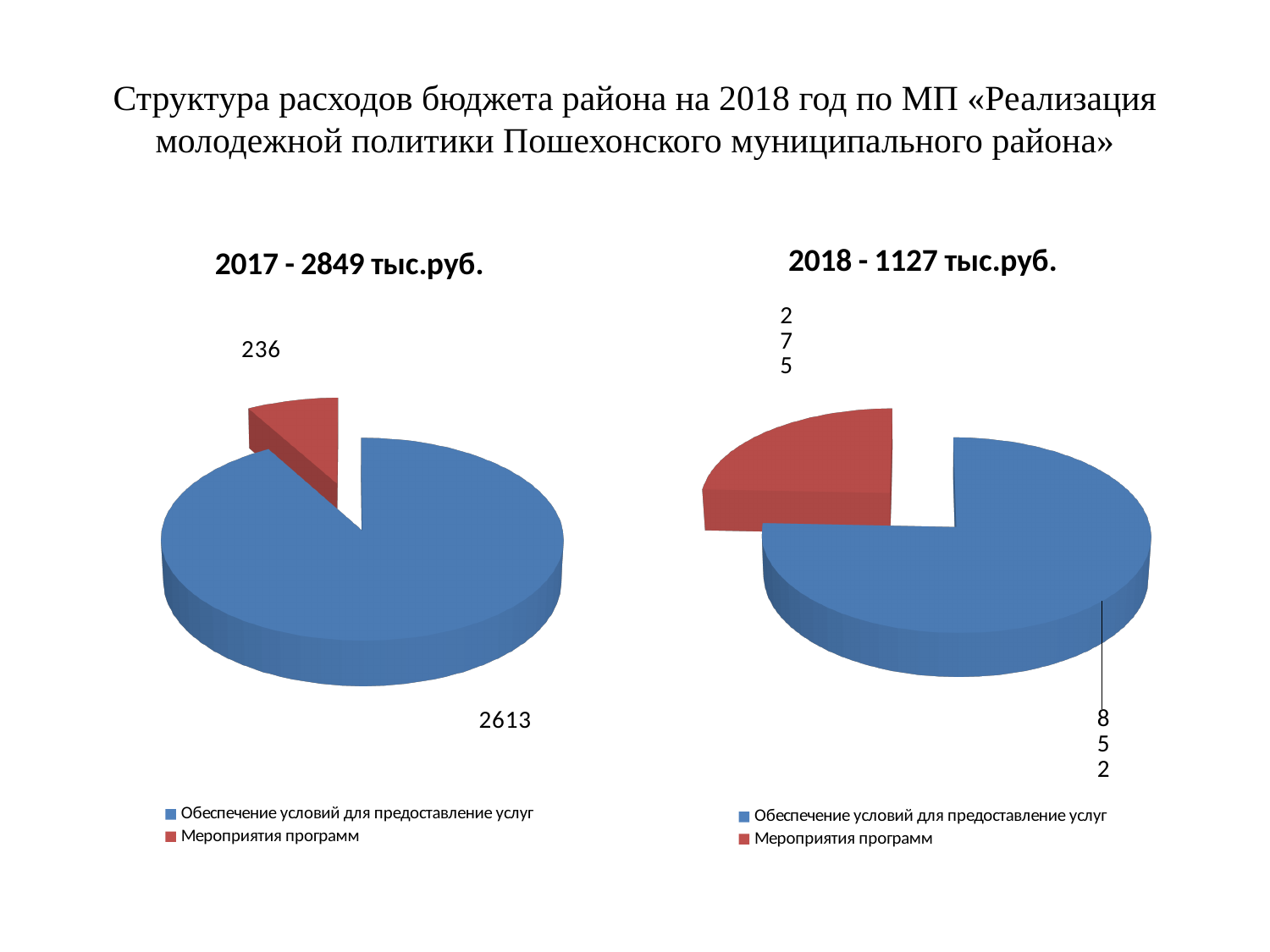
In the chart titled "2017 - 2849 тыс.руб.", what is the value for "Мероприятия программ"? 236 Which is larger: the value for "Мероприятия программ" in the 2017 chart or in the 2018 chart? 2018 chart (275) In the chart titled "2018 - 1127 тыс.руб.", what is the difference between the two slice values? 577 In the chart titled "2017 - 2849 тыс.руб.", what colour is the slice for "Мероприятия программ"? Red In the chart titled "2018 - 1127 тыс.руб.", what is the value for "Обеспечение условий для предоставление услуг"? 852 How many slices does the chart titled "2018 - 1127 тыс.руб." have? 2 In the chart titled "2018 - 1127 тыс.руб.", what is the value for "Мероприятия программ"? 275 In the chart titled "2017 - 2849 тыс.руб.", which category has the largest slice? Обеспечение условий для предоставление услуг In the chart titled "2017 - 2849 тыс.руб.", what is the value for "Обеспечение условий для предоставление услуг"? 2613 In the chart titled "2018 - 1127 тыс.руб.", which category has the smallest slice? Мероприятия программ In the chart titled "2017 - 2849 тыс.руб.", what is the difference between the two slice values? 2377 What type of chart is used on the slide for the 2017 and 2018 data? Pie chart